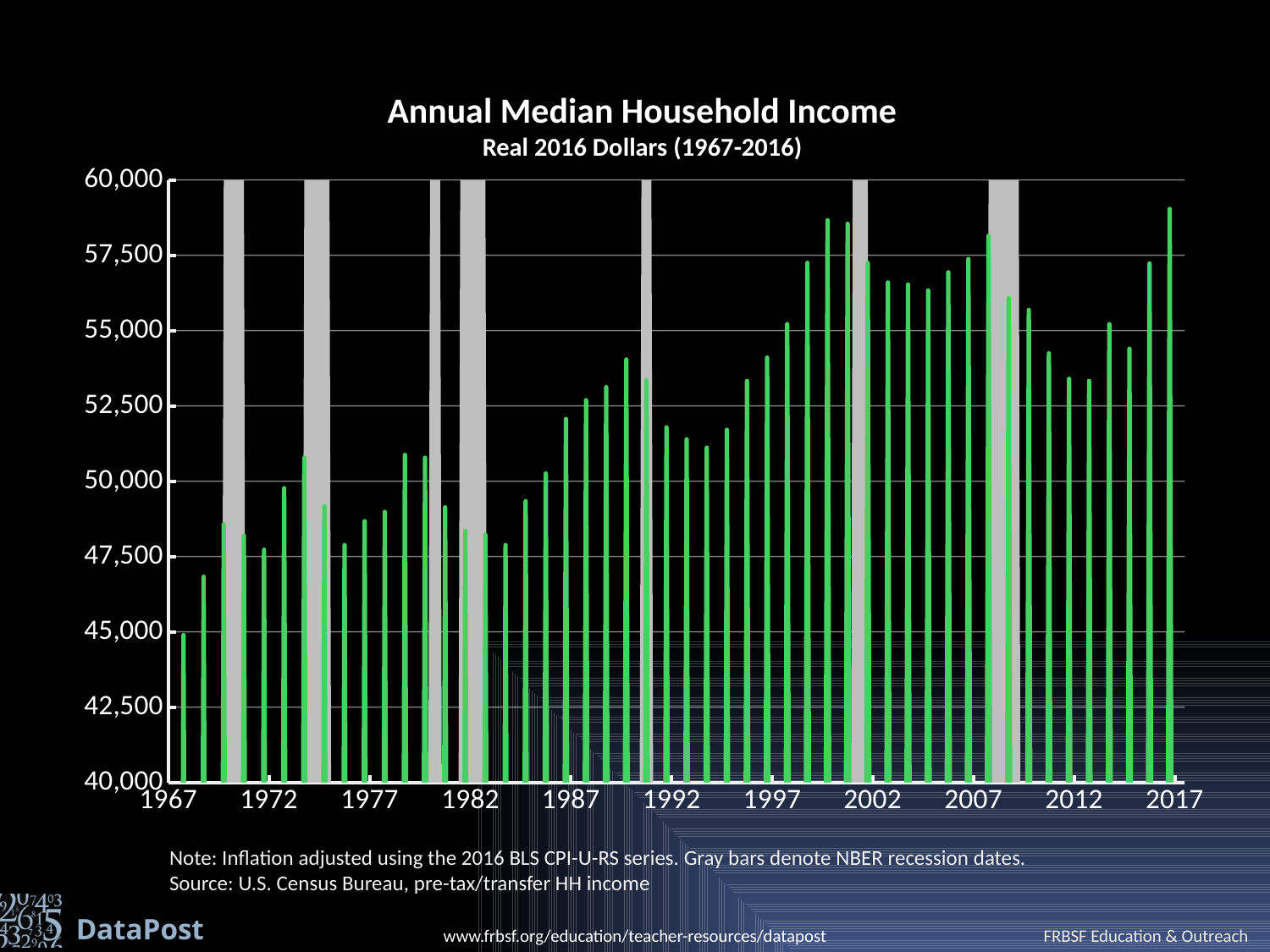
Is the value for 2002 greater or less than 55,000? greater According to the note, what do the gray bars on the chart denote? NBER recession dates Is the value for 1982 greater or less than 50,000? less Which year has the highest median household income on the chart? 2016 What kind of chart is shown on the slide? bar chart Is the value for 1977 greater or less than 50,000? less Which year has the lowest median household income on the chart? 1967 What is the title of the chart? Annual Median Household Income Overall, does median household income rise or fall from 1967 to 2016? rise Which is larger, the median household income in 1992 or in 2002? 2002